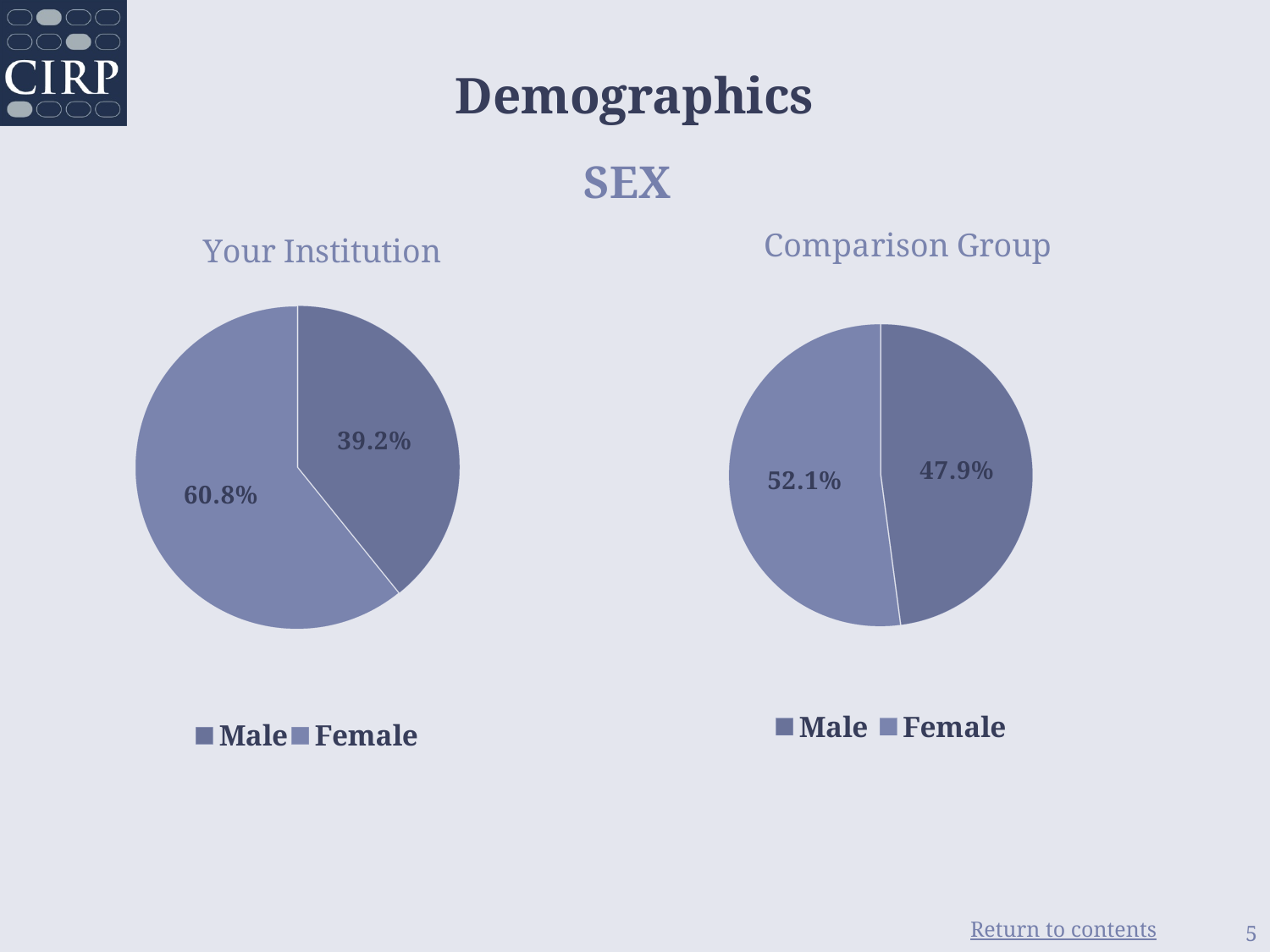
In the 'Your Institution' chart, what is the difference between the Female and Male percentages? 21.6% In the 'Your Institution' chart, what percentage is Male? 39.2% In the 'Your Institution' chart, what percentage is Female? 60.8% In the 'Comparison Group' chart, what is the difference between the Female and Male percentages? 4.2% How many entries does the legend of the 'Your Institution' chart list? 2 How many slices does the 'Comparison Group' pie chart have? 2 In the 'Comparison Group' chart, which category has the smaller share? Male Is the Male share larger in the 'Your Institution' chart or the 'Comparison Group' chart? Comparison Group In the 'Your Institution' chart, which category has the larger share? Female What type of chart is the 'Your Institution' chart? Pie chart In the 'Comparison Group' chart, what percentage is Female? 52.1% In the 'Comparison Group' chart, what percentage is Male? 47.9%